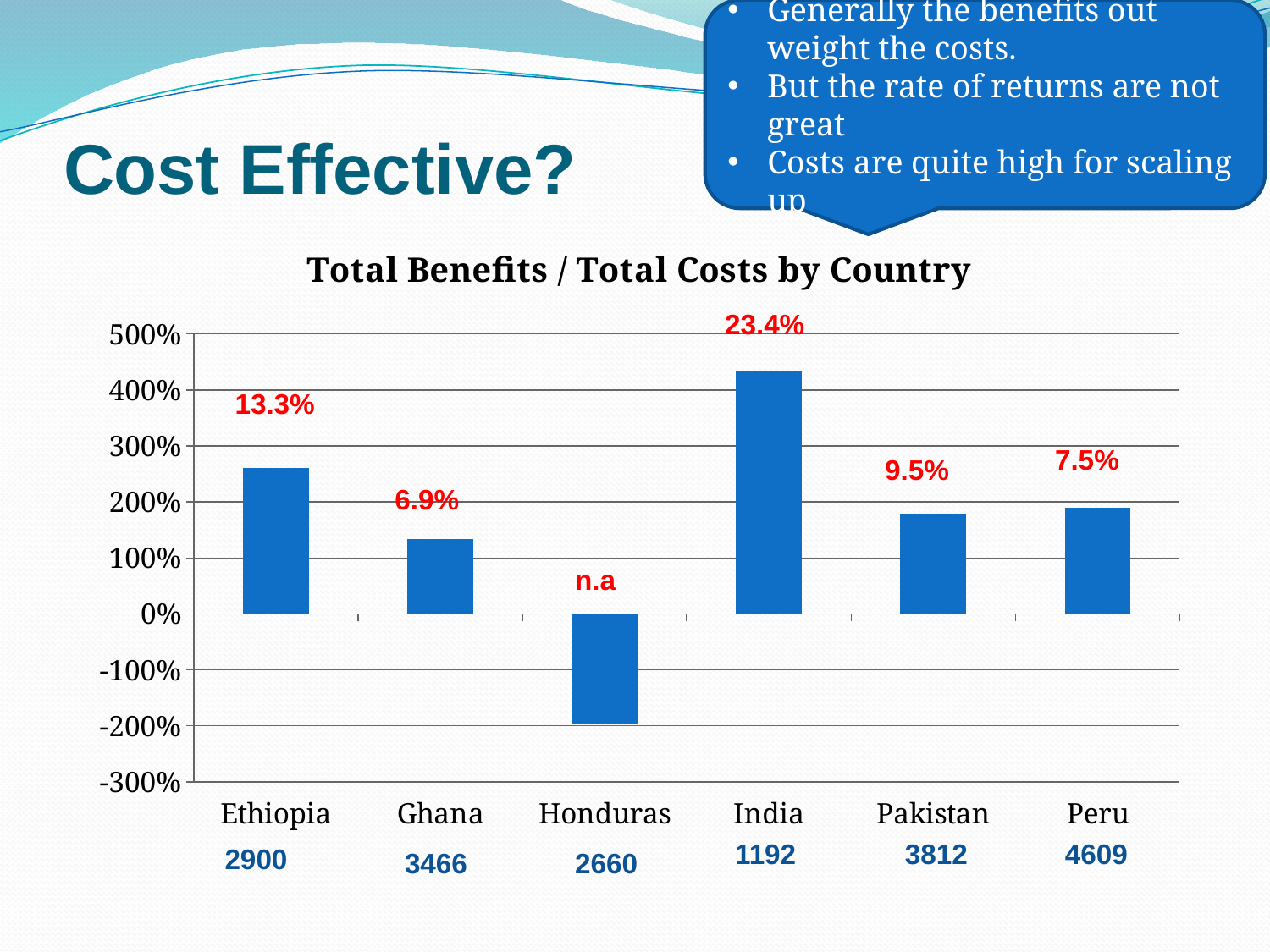
Is the bar for Ethiopia greater or less than 200%? greater Is the bar for Pakistan greater or less than 300%? less Which country has the highest bar in the chart? India Is the bar for Ghana greater or less than 100%? greater How many countries are shown on the x axis of the chart? 6 Which country has the lowest bar in the chart? Honduras What red label is printed above the India bar? 23.4% Which has the larger bar, Ethiopia or Ghana? Ethiopia What type of chart is shown on the slide? bar chart What is the title of the chart? Total Benefits / Total Costs by Country